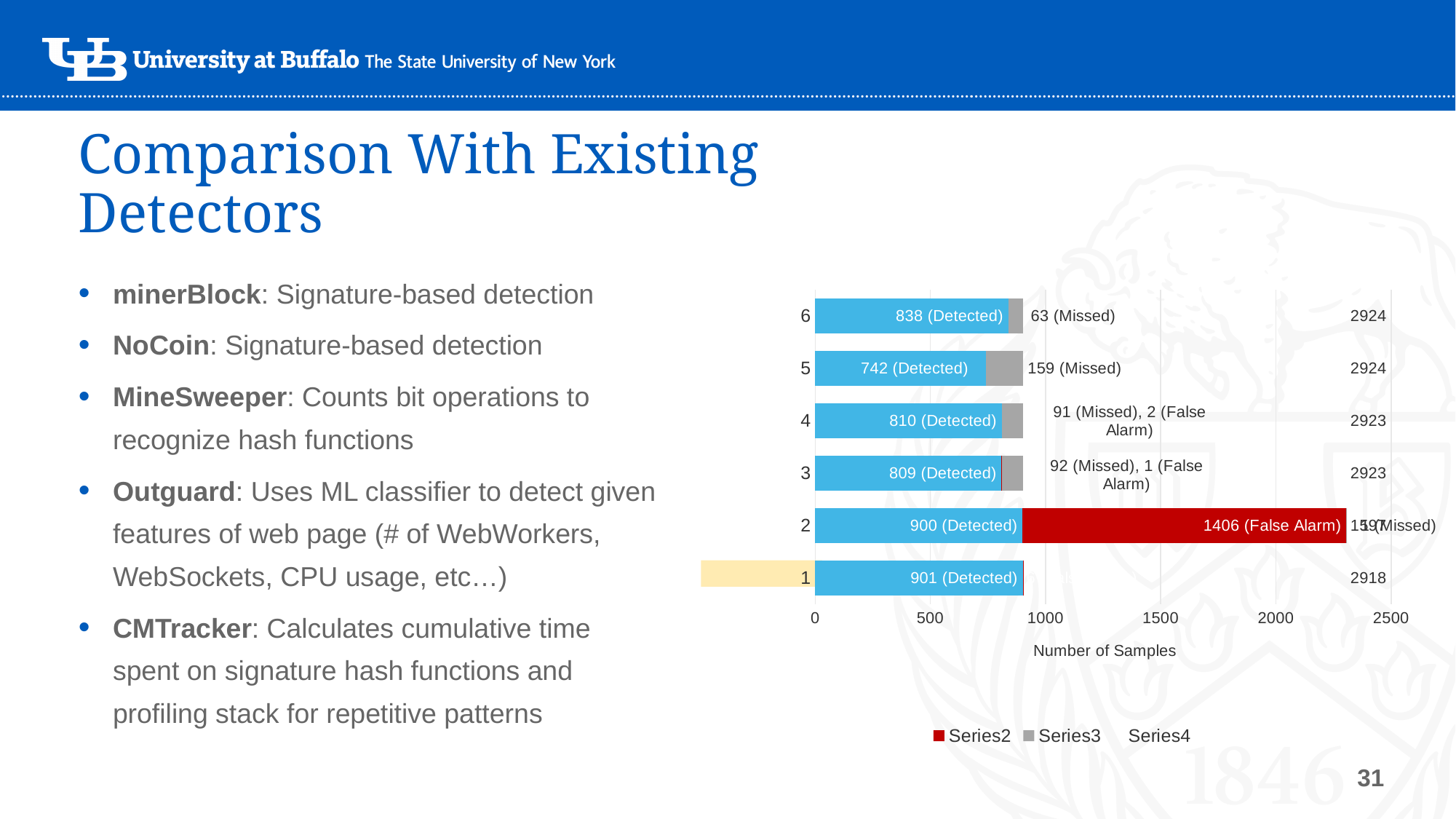
What is the difference between the Detected values of category 6 and category 5? 96 Which category has the highest Detected value? 1 How many samples are labelled as Missed for category 6? 63 (Missed) Which is larger, the Detected value for category 4 or for category 3? category 4 How many categories are shown on the vertical axis of the chart? 6 What is the Detected value for category 6? 838 (Detected) What is the False Alarm value labelled on the bar for category 2? 1406 (False Alarm) What kind of chart is shown on the slide? bar chart What is the Detected value for category 5? 742 (Detected) What is the label of the horizontal axis of the chart? Number of Samples Which category has the lowest Detected value? 5 How many samples are labelled as Missed for category 5? 159 (Missed)